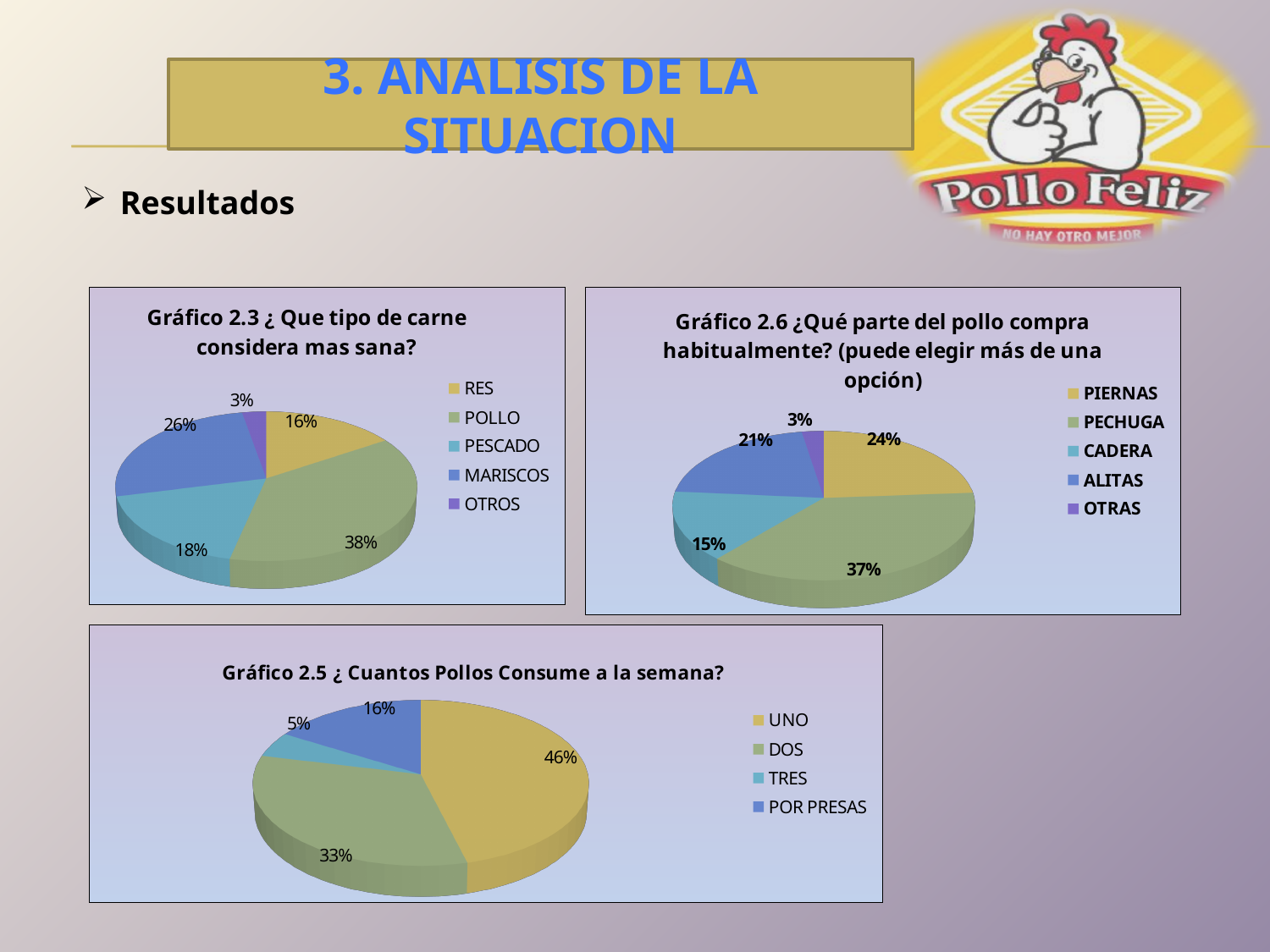
In Gráfico 2.6, what is the share for CADERA? 15% In Gráfico 2.5, what is the difference between the shares for UNO and DOS? 13% In Gráfico 2.6, which part of the chicken has the largest share? PECHUGA What kind of chart is Gráfico 2.5? Pie chart In Gráfico 2.3, how many categories does the legend list? 5 In Gráfico 2.3, which type of meat has the smallest share? OTROS In Gráfico 2.6, which is larger, the share for PIERNAS or the share for ALITAS? PIERNAS In Gráfico 2.3, what share of respondents consider POLLO the healthiest type of meat? 38% In Gráfico 2.3, what is the difference between the shares for MARISCOS and PESCADO? 8% In Gráfico 2.5, what share of respondents consume UNO (one) chicken per week? 46% In Gráfico 2.5, which category has the smallest share? TRES In Gráfico 2.6, what share corresponds to PECHUGA? 37%